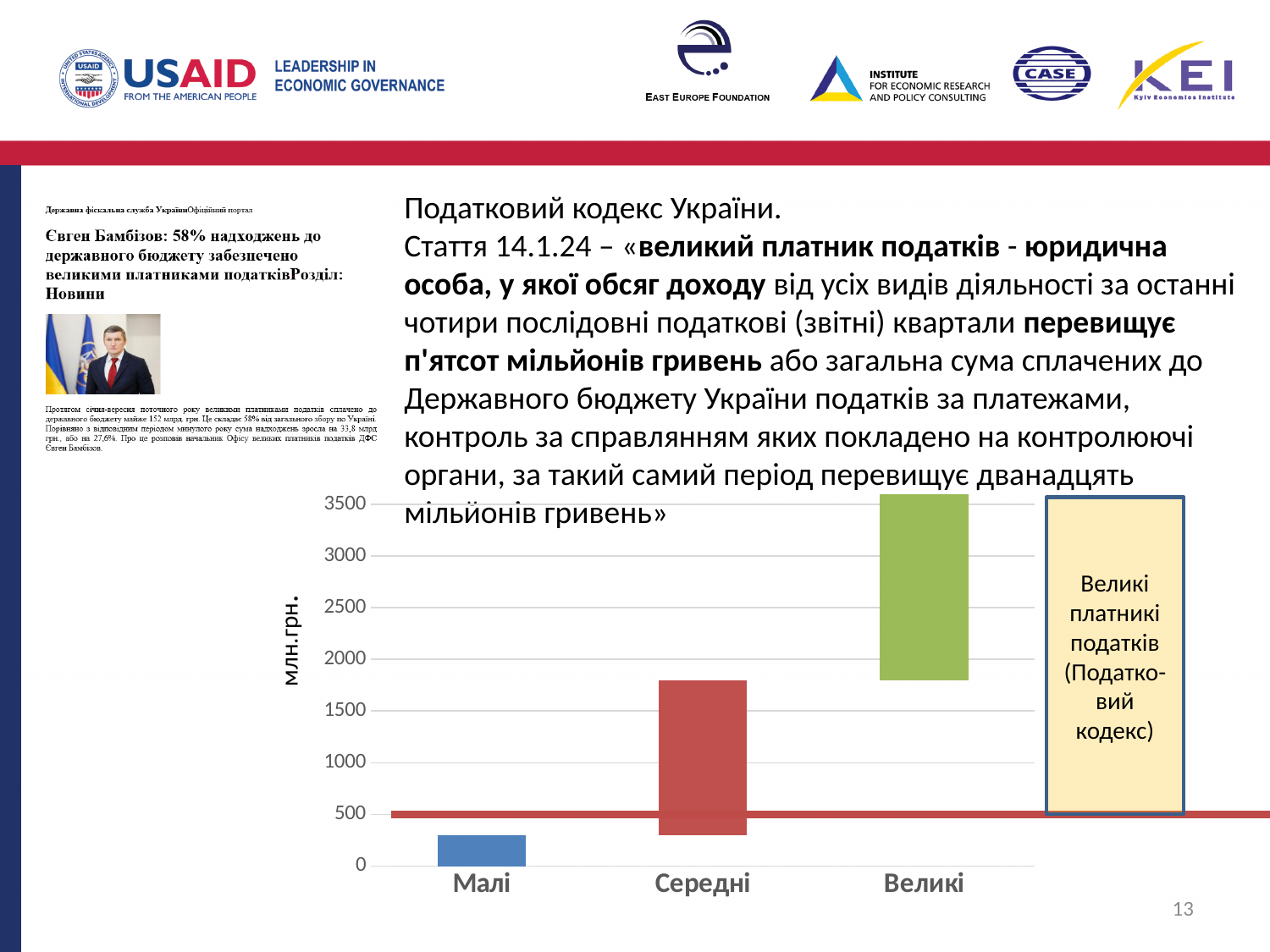
Which category has the lowest bar in the chart? Малі How many categories are shown on the x axis of the chart? 3 Do the bars rise or fall from left to right across the x axis? rise Which category has the highest bar in the chart? Великі Is the top of the bar for Великі greater or less than 3000? greater At which value on the vertical axis is the red horizontal line drawn across the chart? 500 Which bar reaches higher, Середні or Малі? Середні Is the top of the bar for Середні greater or less than 1500? greater What kind of chart is shown on the slide? bar chart Is the top of the bar for Середні greater or less than 2000? less What is the label on the vertical axis of the chart? млн.грн.